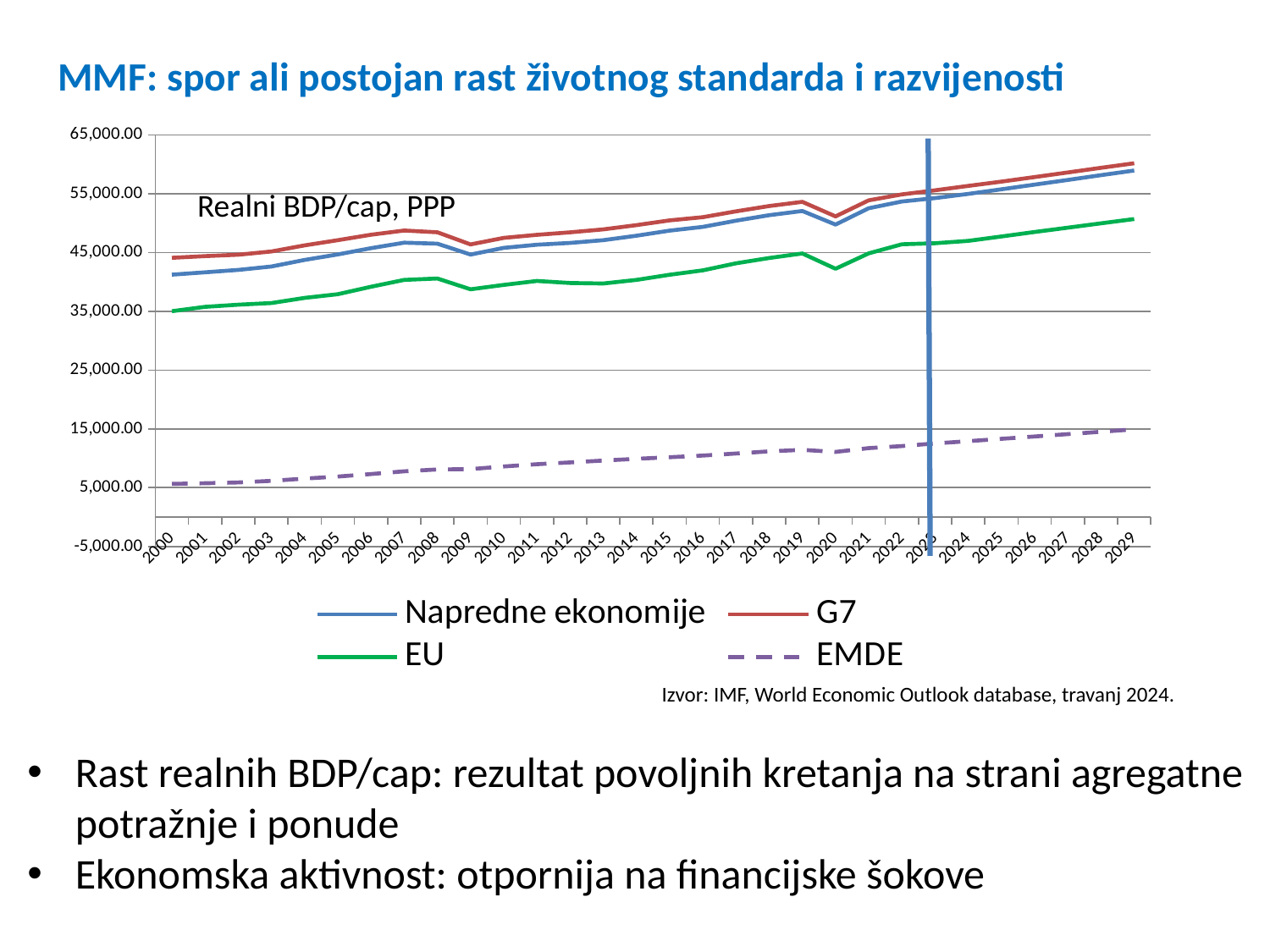
Which series is drawn with a dashed line? EMDE What kind of chart is shown on the slide? line chart How many years are plotted along the x axis? 30 Which series has the lowest values across the whole period? EMDE Do the values for EMDE rise or fall from 2000 to 2029? rise Which is larger in 2010, the value for EU or the value for EMDE? EU How many series does the legend list? 4 What label is printed inside the plot area of the chart? Realni BDP/cap, PPP Which series has the highest values across the whole period? G7 Is the value for EU in 2029 greater or less than 45,000.00? greater Is the value for Napredne ekonomije in 2000 greater or less than 45,000.00? less Is the value for G7 in 2029 greater or less than 55,000.00? greater